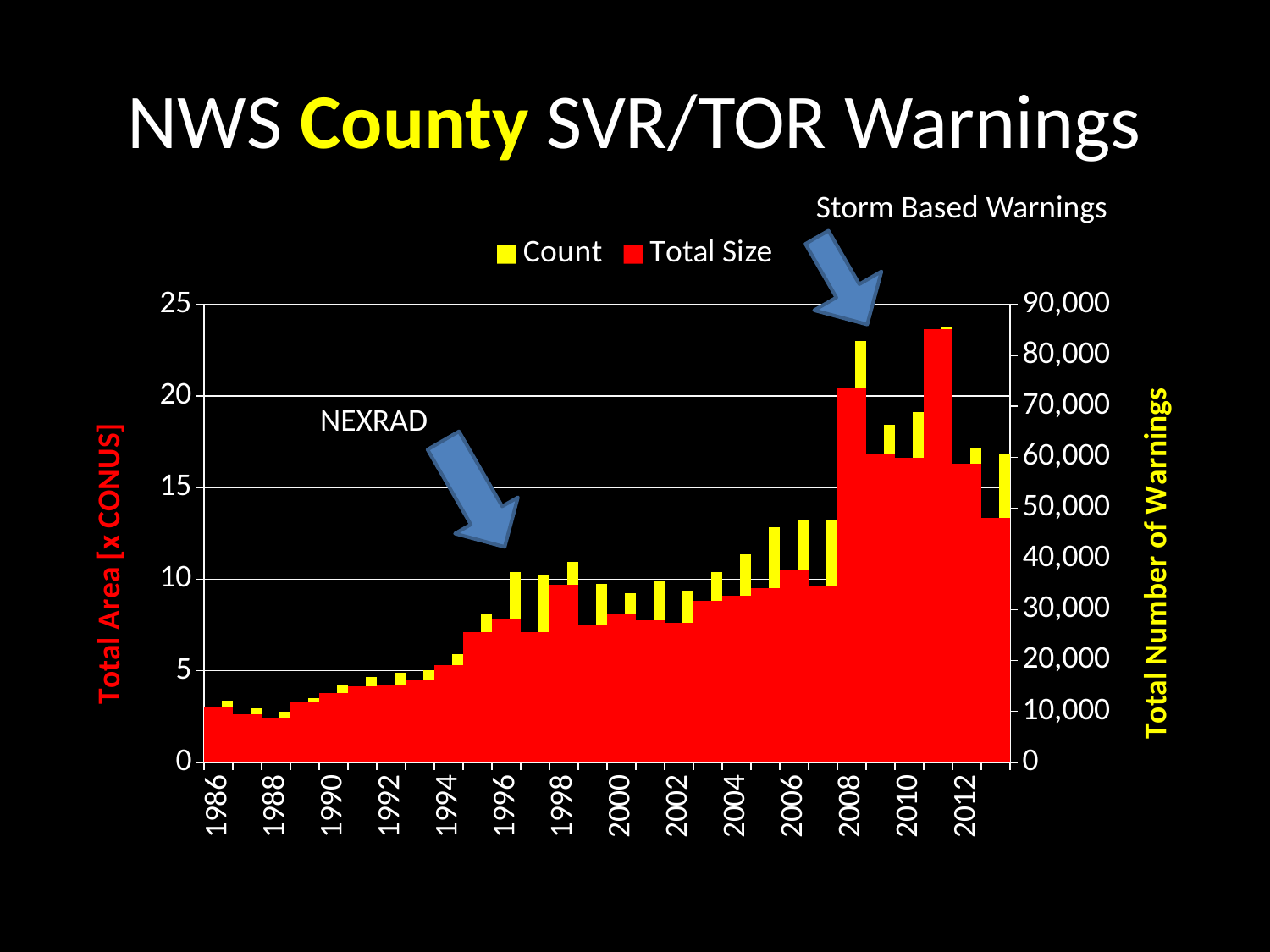
How many series does the chart legend list? 2 What are the two series named in the chart legend? Count and Total Size Which year has the larger Count value, 2008 or 2010? 2008 Is the Count value for 2008 greater or less than 80,000? greater Is the Total Size value for 2011 greater or less than 20? greater In which year is the Total Size series (red area) lowest? 1988 In which year is the Count series (yellow bars) highest? 2011 Is the Total Size value for 1986 greater or less than 5? less What is the title of the right-hand vertical axis? Total Number of Warnings In which year is the Total Size series (red area) highest? 2011 Overall, does the Total Size series rise or fall from 1986 to 2008? rise